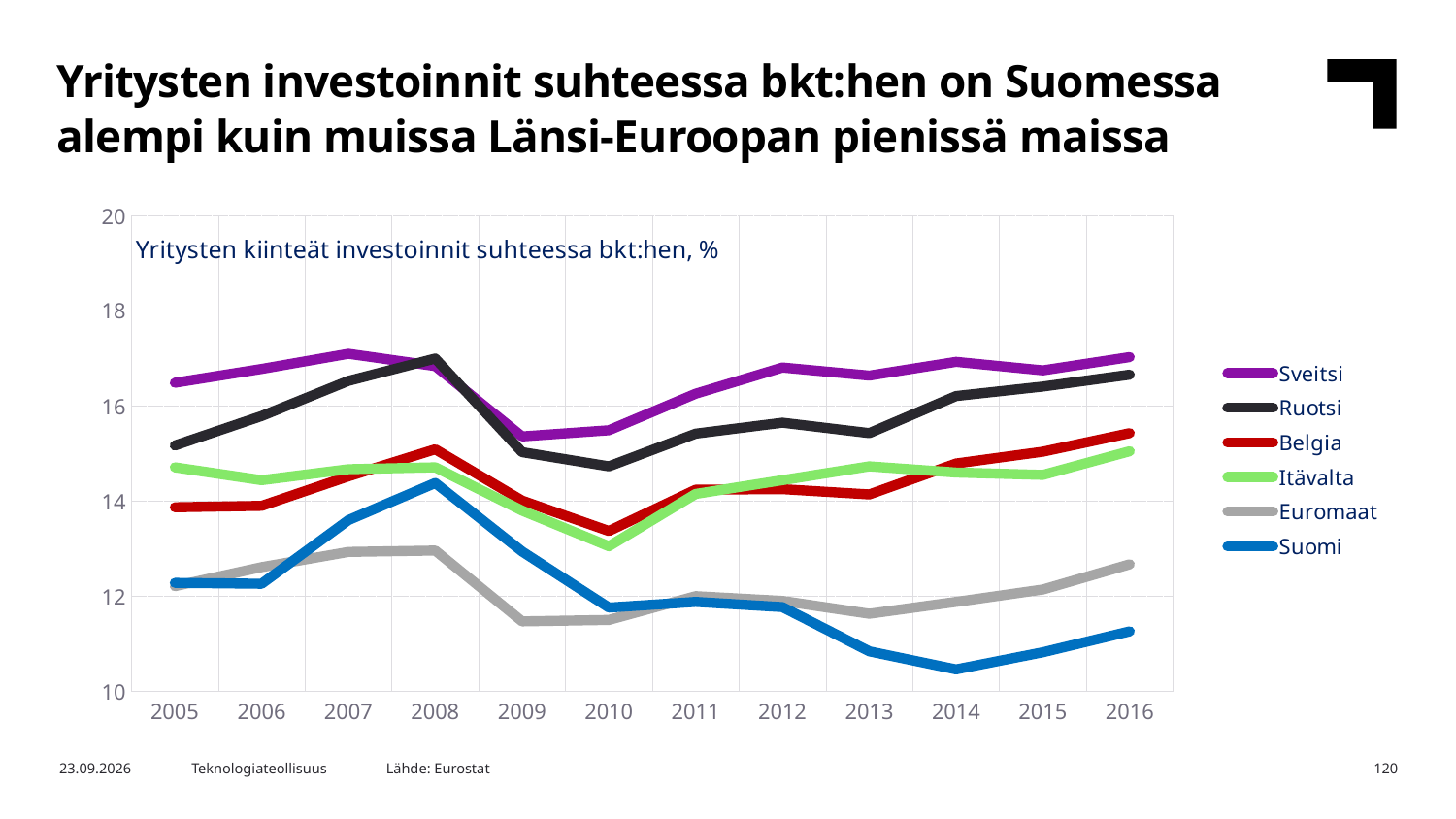
Is the value for Sveitsi in 2007 greater or less than 16? greater Which series has the highest value in 2012? Sveitsi Which series has the lowest value in 2009? Euromaat What is the subtitle printed inside the chart area? Yritysten kiinteät investoinnit suhteessa bkt:hen, % In 2008, which is larger, the value for Ruotsi or the value for Belgia? Ruotsi How many series does the legend list? 6 Is the value for Ruotsi in 2010 greater or less than 16? less Does the value for Suomi rise or fall from 2008 to 2014? fall What kind of chart is shown on the slide? line chart How many years are shown on the x axis? 12 Which country has the lowest value in 2016? Suomi Is the value for Suomi in 2014 greater or less than 12? less